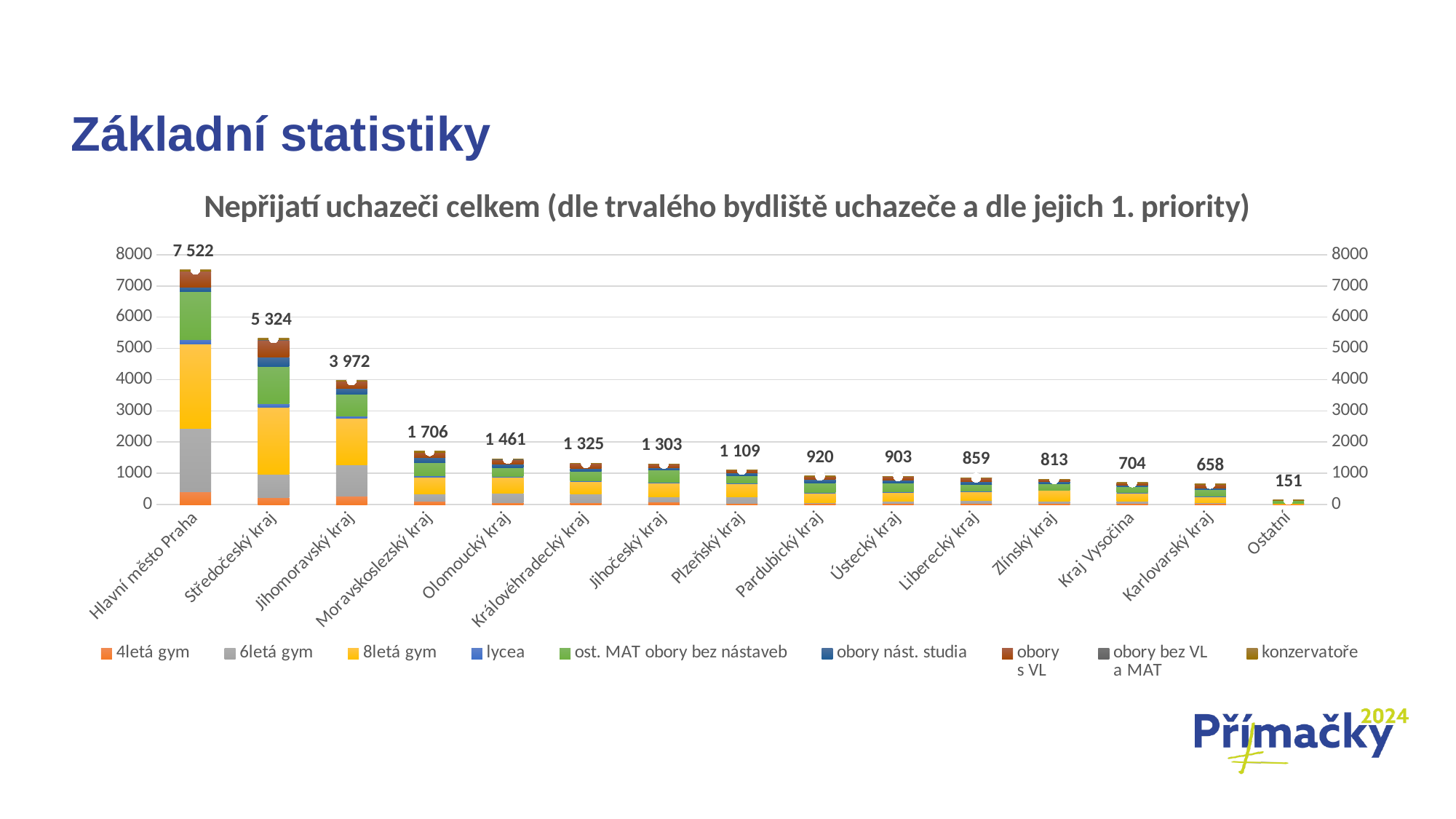
What is the total value labelled for Středočeský kraj? 5 324 How many categories are shown on the x axis? 15 What is the difference between the totals for Hlavní město Praha and Středočeský kraj? 2 198 Which has a larger total, Jihočeský kraj or Plzeňský kraj? Jihočeský kraj What is the total number of unaccepted applicants shown for Hlavní město Praha? 7 522 What is the difference between the totals for Moravskoslezský kraj and Olomoucký kraj? 245 Which category has the highest total? Hlavní město Praha Do the bar totals rise or fall from left to right along the x axis? Fall Which category has the lowest total? Ostatní What is the total value labelled for Kraj Vysočina? 704 What kind of chart is shown on the slide? Stacked bar chart How many series does the legend list? 9